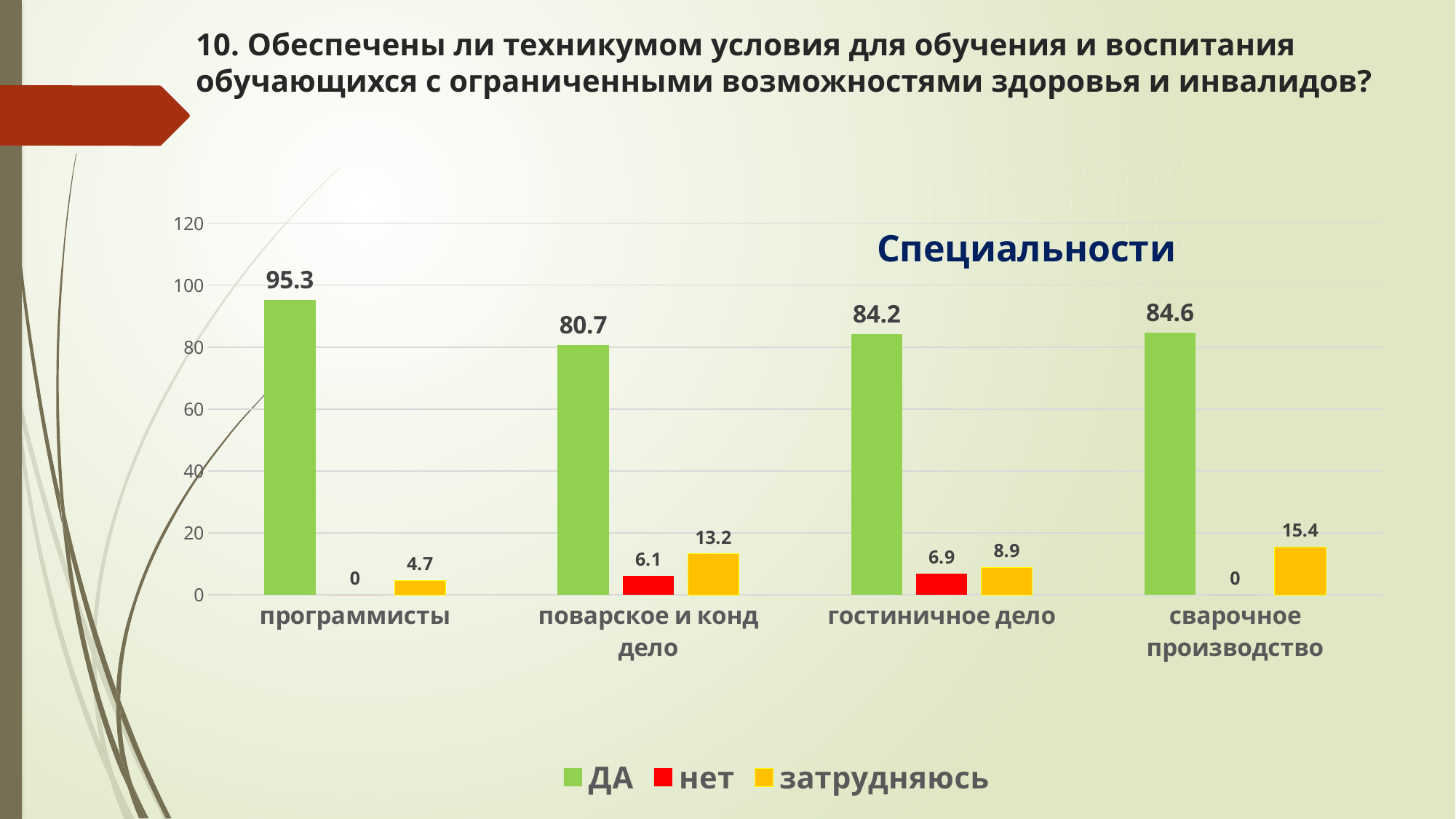
What is the value of the нет series for гостиничное дело? 6.9 Which is larger: the затрудняюсь value for поварское и конд дело or for гостиничное дело? поварское и конд дело What kind of chart is shown on the slide? bar chart How many series does the legend list? 3 What is the value of the затрудняюсь series for сварочное производство? 15.4 Which category has the lowest value in the ДА series? поварское и конд дело How many categories are shown on the x axis? 4 Which category has the highest value in the ДА series? программисты Is the ДА value for сварочное производство greater or less than 80? greater What is the difference between the ДА values for программисты and поварское и конд дело? 14.6 What colour represents the нет series in the chart? red What is the value of the ДА series for программисты? 95.3